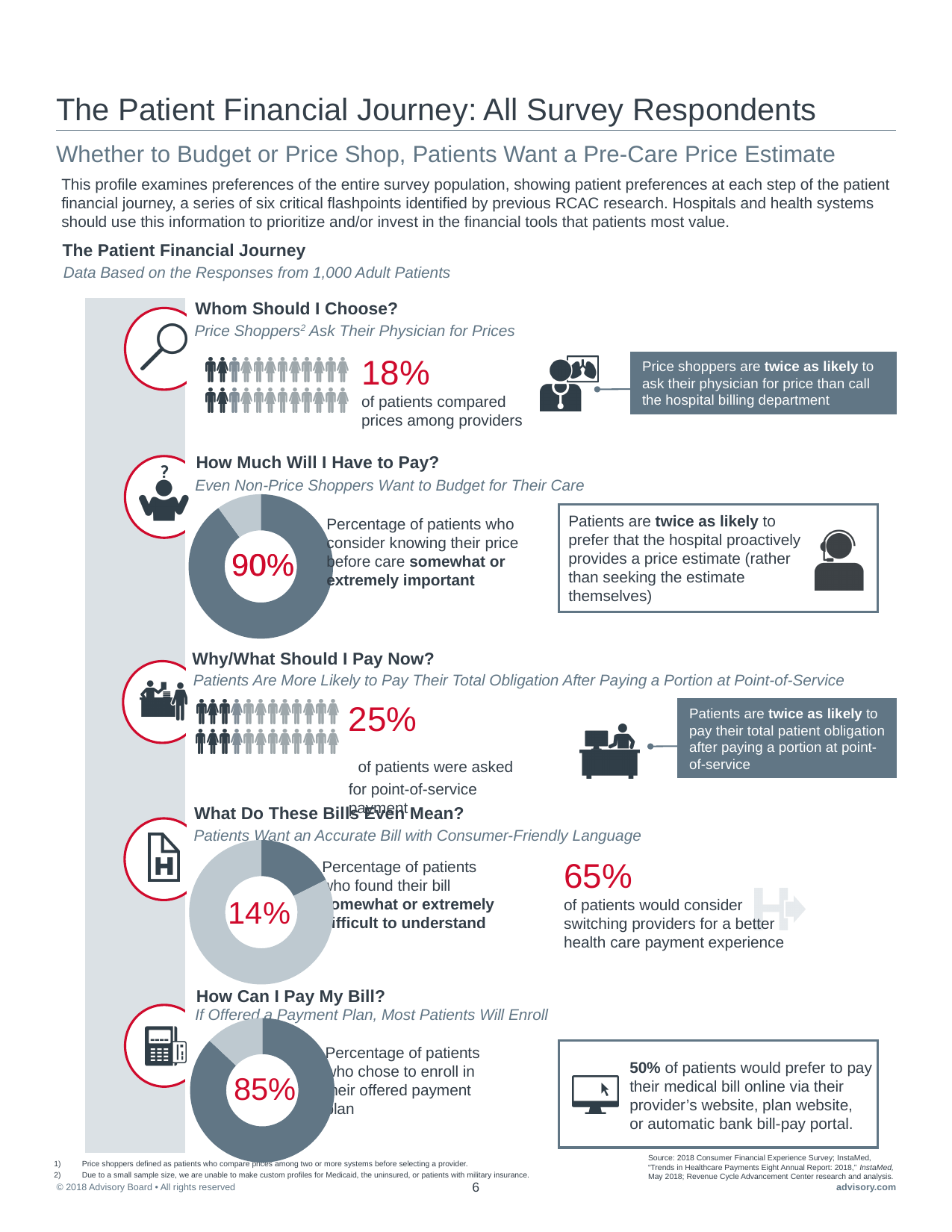
What is the difference between the percentage in the 'How Much Will I Have to Pay?' donut chart and the percentage in the 'How Can I Pay My Bill?' donut chart? 5 percentage points What kind of chart is used to show the 90%, 14% and 85% figures on the slide? Donut (pie) chart Which donut chart on the slide shows the lowest percentage? What Do These Bills Even Mean? (14%) In the pictogram under 'Why/What Should I Pay Now?', what percentage of patients were asked for point-of-service payment? 25% In the donut chart under 'What Do These Bills Even Mean?', what percentage of patients found their bill somewhat or extremely difficult to understand? 14% In the donut chart under 'How Can I Pay My Bill?', what percentage of patients chose to enroll in their offered payment plan? 85% In the pictogram under 'Whom Should I Choose?', what percentage of patients compared prices among providers? 18% In the donut chart under 'How Much Will I Have to Pay?', what percentage of patients consider knowing their price before care somewhat or extremely important? 90% Which donut chart on the slide shows the highest percentage? How Much Will I Have to Pay? (90%) Which is larger: the percentage in the 'How Can I Pay My Bill?' donut chart or the percentage in the 'What Do These Bills Even Mean?' donut chart? How Can I Pay My Bill? (85%) How many donut charts are shown on the slide? 3 What is the difference between the percentage in the 'How Much Will I Have to Pay?' donut chart and the percentage in the 'What Do These Bills Even Mean?' donut chart? 76 percentage points